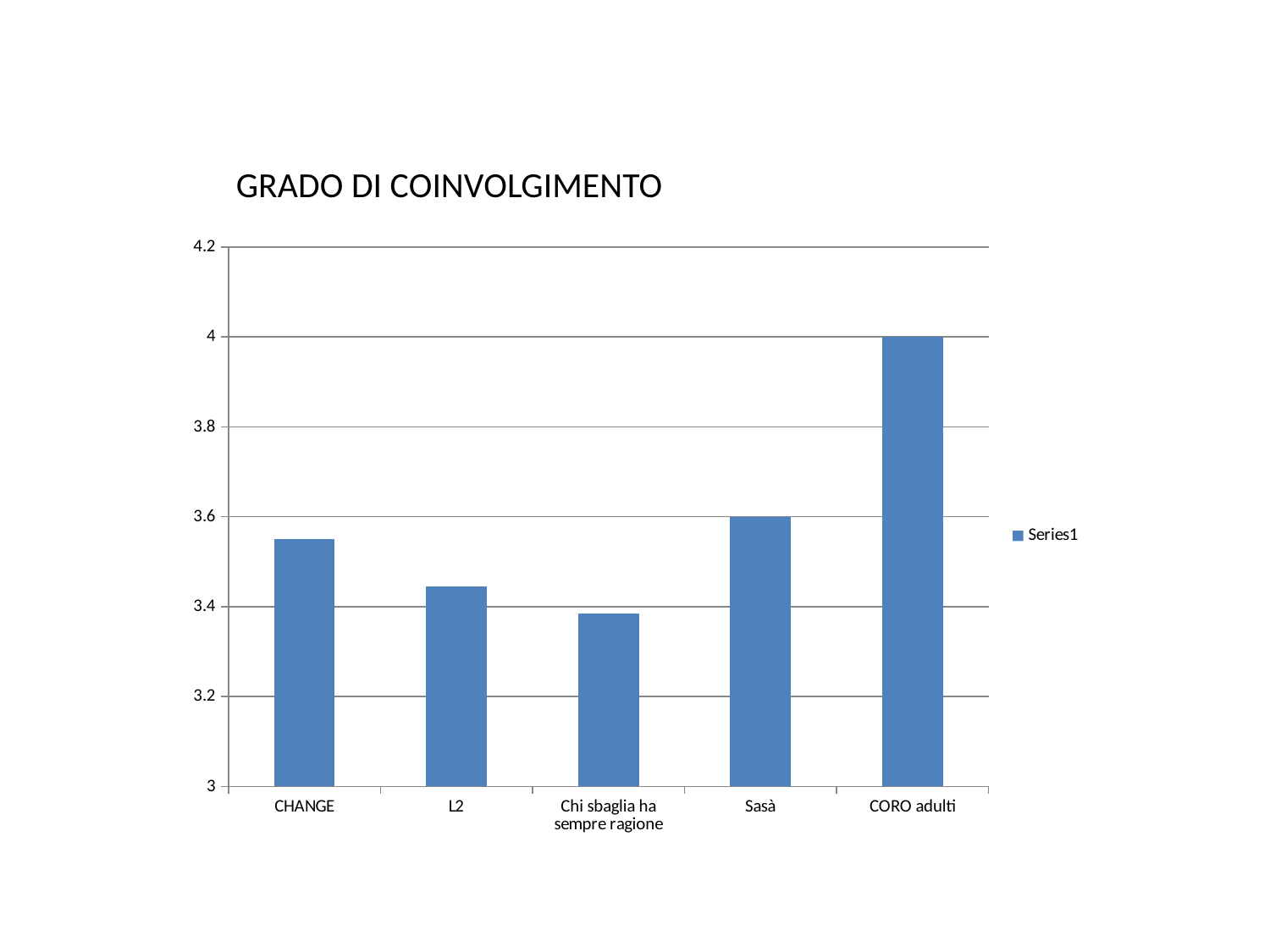
How many series does the legend list? 1 Is the value for Chi sbaglia ha sempre ragione greater or less than 3.4? less Which category has the highest value? CORO adulti How many categories are shown on the x axis of the chart? 5 Which is larger, the value for CHANGE or the value for L2? CHANGE What is the value for Sasà? 3.6 What is the title of the chart? GRADO DI COINVOLGIMENTO What kind of chart is shown on the slide? bar chart What is the value for CORO adulti? 4 What is the name of the series shown in the legend? Series1 Which category has the lowest value? Chi sbaglia ha sempre ragione Is the value for CHANGE greater or less than 3.4? greater